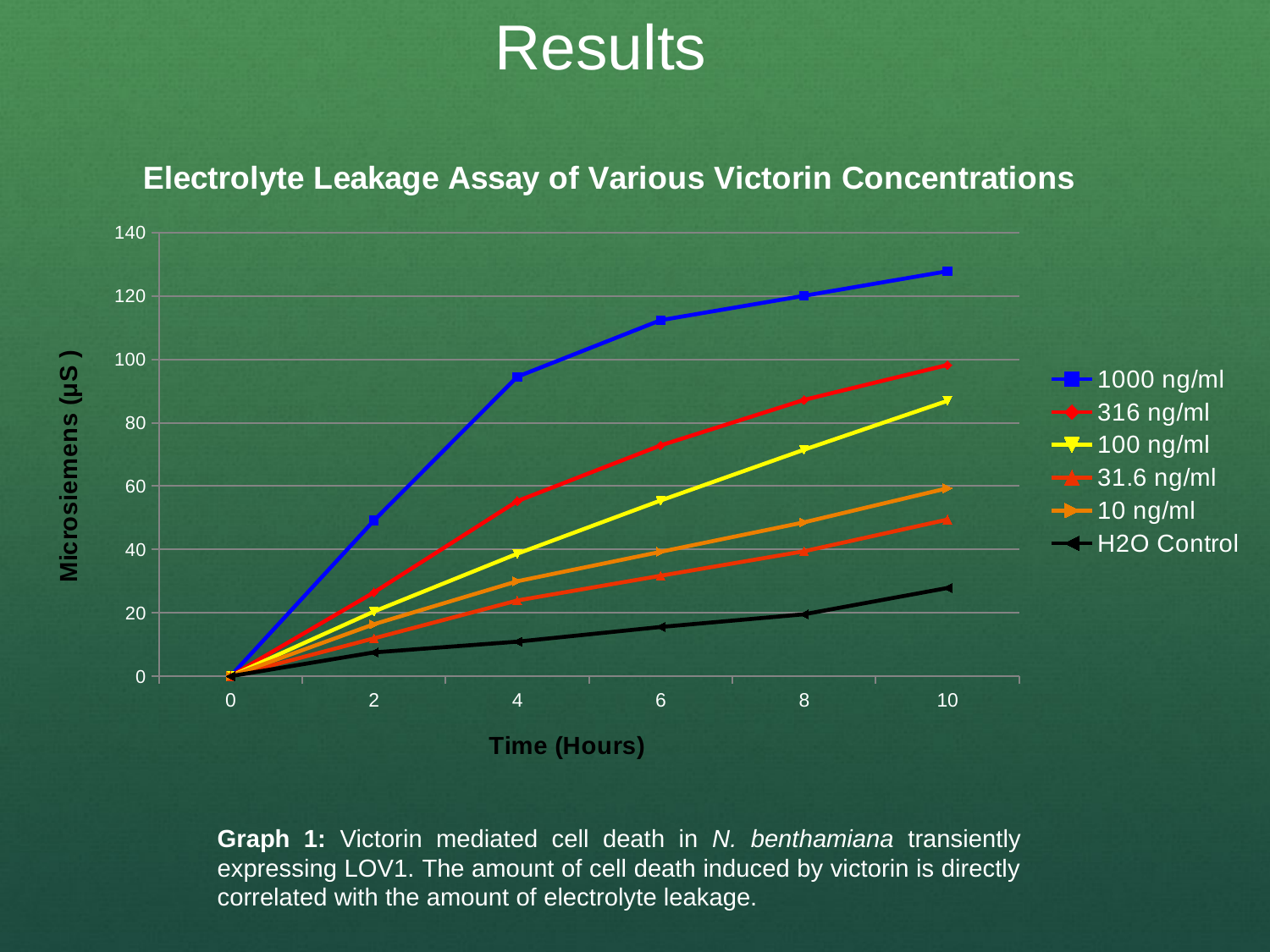
Is the value for 1000 ng/ml at 10 hours greater or less than 120? greater Do the values for 1000 ng/ml rise or fall as time increases from 0 to 10 hours? rise Is the value for H2O Control at 10 hours greater or less than 20? greater Which series has the highest value at 10 hours? 1000 ng/ml What is the title of the chart? Electrolyte Leakage Assay of Various Victorin Concentrations Is the value for 1000 ng/ml at 4 hours greater or less than 80? greater At 6 hours, which is larger: the value for 316 ng/ml or the value for 100 ng/ml? 316 ng/ml How many series does the legend list? 6 Which series has the lowest value at 10 hours? H2O Control What kind of chart is shown on the slide? line chart How many time points are plotted for each series? 6